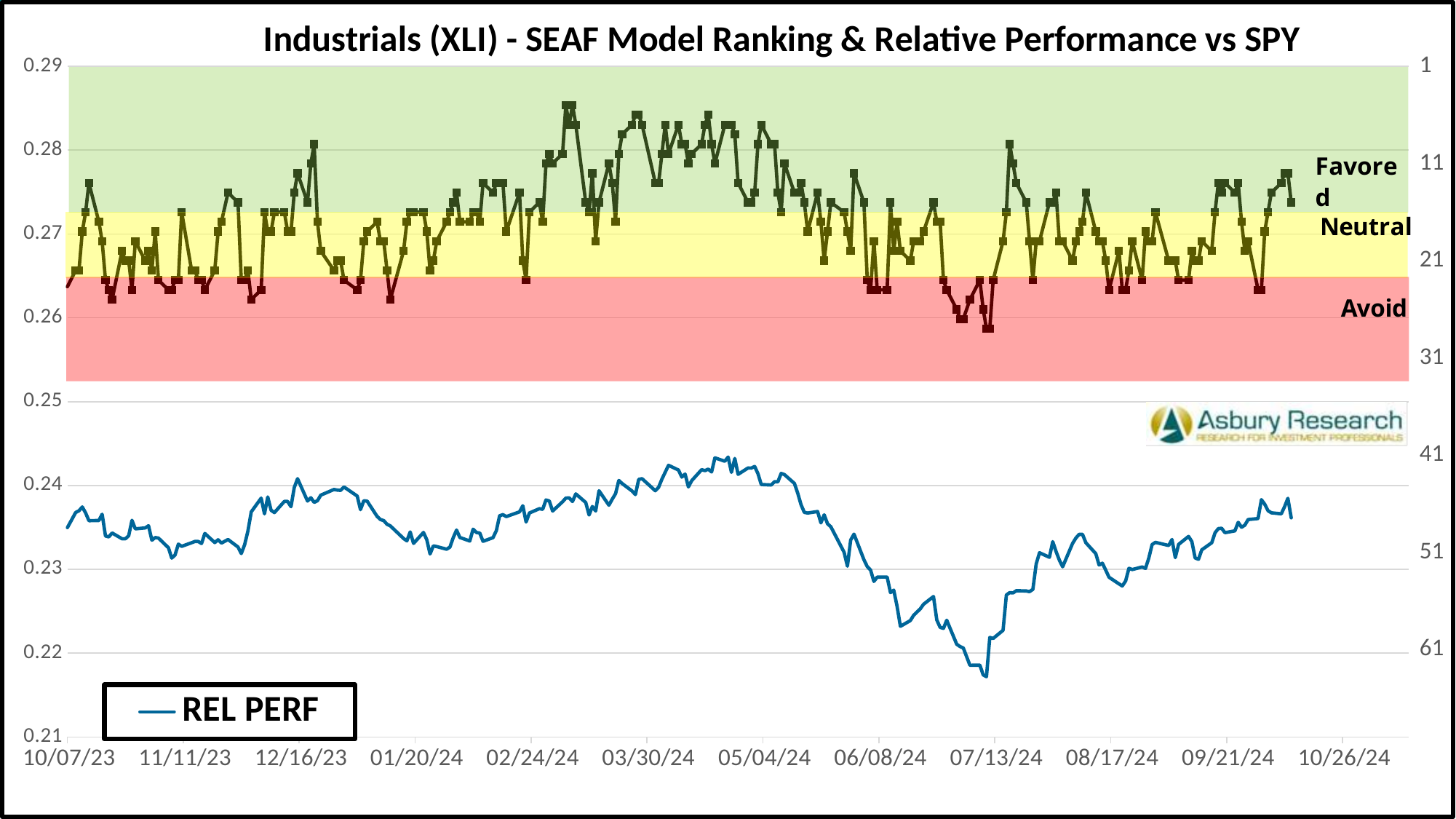
Is the REL PERF value at its lowest point near 07/13/24 greater or less than 0.22? less What is the title of the chart? Industrials (XLI) - SEAF Model Ranking & Relative Performance vs SPY How many series does the legend list? 1 Is the REL PERF value at its peak shortly before 05/04/24 greater or less than 0.24? greater Does the REL PERF line rise or fall between 07/13/24 and 09/21/24? rise How many date labels are shown on the x axis? 12 Is the REL PERF value at 10/07/23 greater or less than 0.23? greater Around which x-axis date does the REL PERF line reach its highest value? 05/04/24 Around which x-axis date does the REL PERF line reach its lowest value? 07/13/24 Does the REL PERF line rise or fall between 06/08/24 and 07/13/24? fall What kind of chart is shown on the slide? line chart What is the name of the series shown in the legend? REL PERF